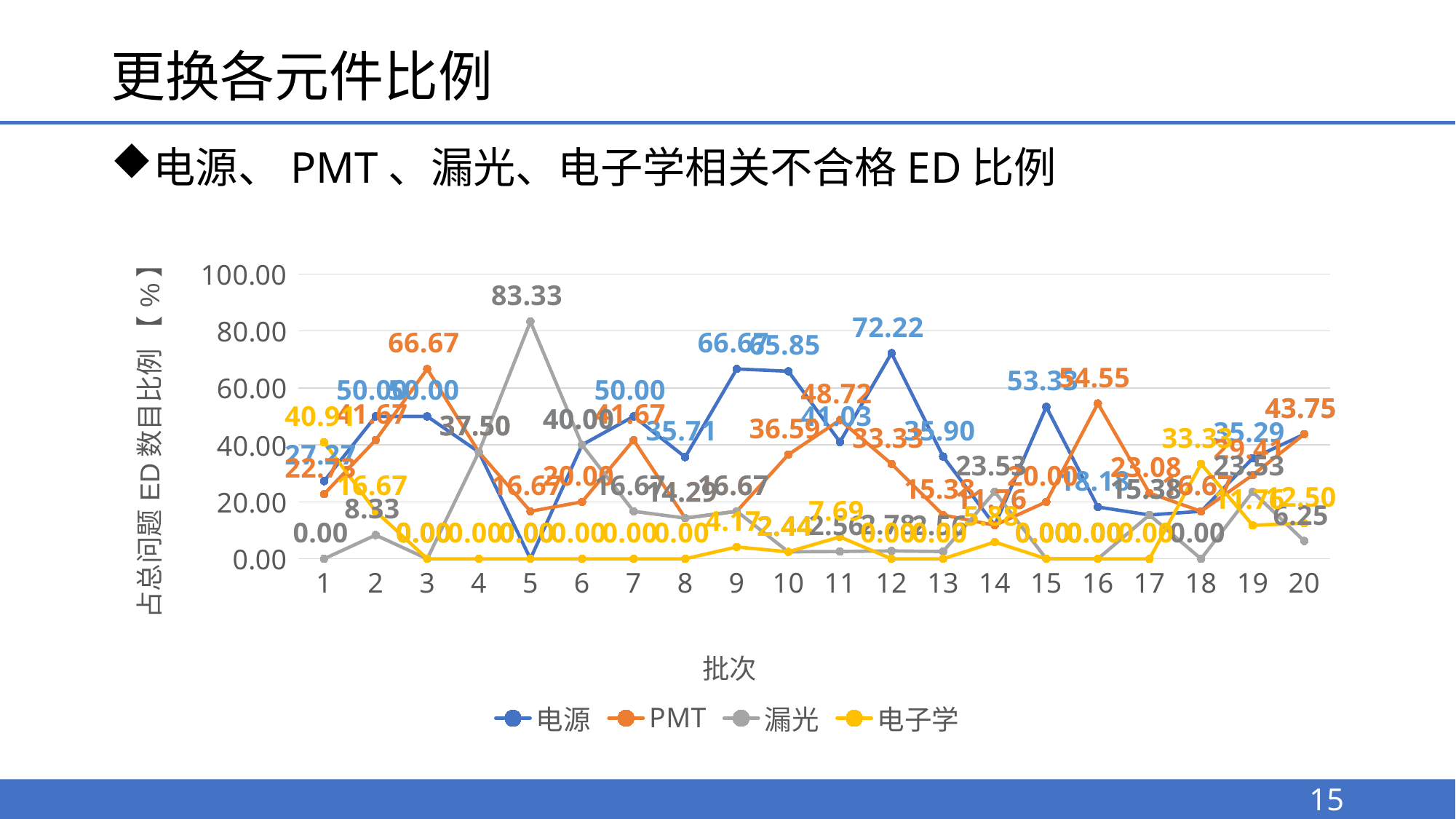
What is the value for PMT at batch 16? 54.55 What is the difference between the 电源 value at batch 12 and the 电源 value at batch 1? 44.95 What kind of chart is shown on the slide? line chart What is the value for 漏光 at batch 2? 8.33 Which series has the highest value at batch 5? 漏光 What is the value for 电源 at batch 12? 72.22 What is the title of the x axis? 批次 How many series does the legend list? 4 What is the value for 电子学 at batch 1? 40.91 At batch 1, which is larger: the value for 电源 or the value for PMT? 电源 What is the value for 漏光 at batch 5? 83.33 How many batches (批次) are plotted along the x axis? 20